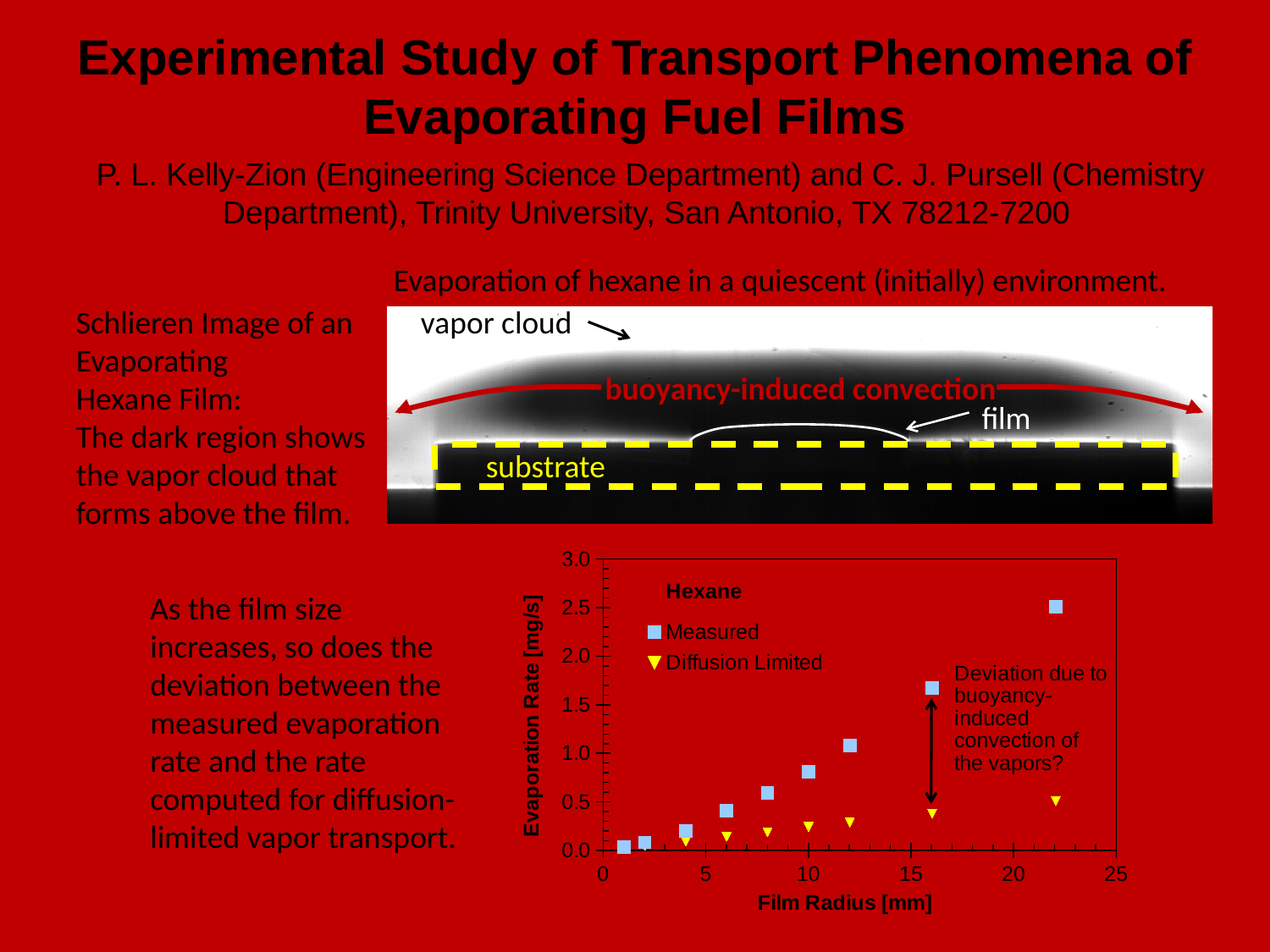
At a film radius of 16 mm, is the Measured evaporation rate greater or less than 1.5 mg/s? greater What kind of chart is shown on the slide? scatter plot At the largest film radius plotted, is the Diffusion Limited value greater or less than 1.0 mg/s? less How many Measured data points are plotted on the chart? 9 At a film radius of 10 mm, is the Measured evaporation rate greater or less than 1.0 mg/s? less At the largest film radius plotted, which series has the larger evaporation rate, Measured or Diffusion Limited? Measured How many series does the chart legend list? 2 Which series reaches the highest evaporation rate on the chart? Measured What are the two series named in the chart legend? Measured and Diffusion Limited What is the title of the chart's x axis? Film Radius [mm] Does the Measured evaporation rate rise or fall as film radius increases? rise